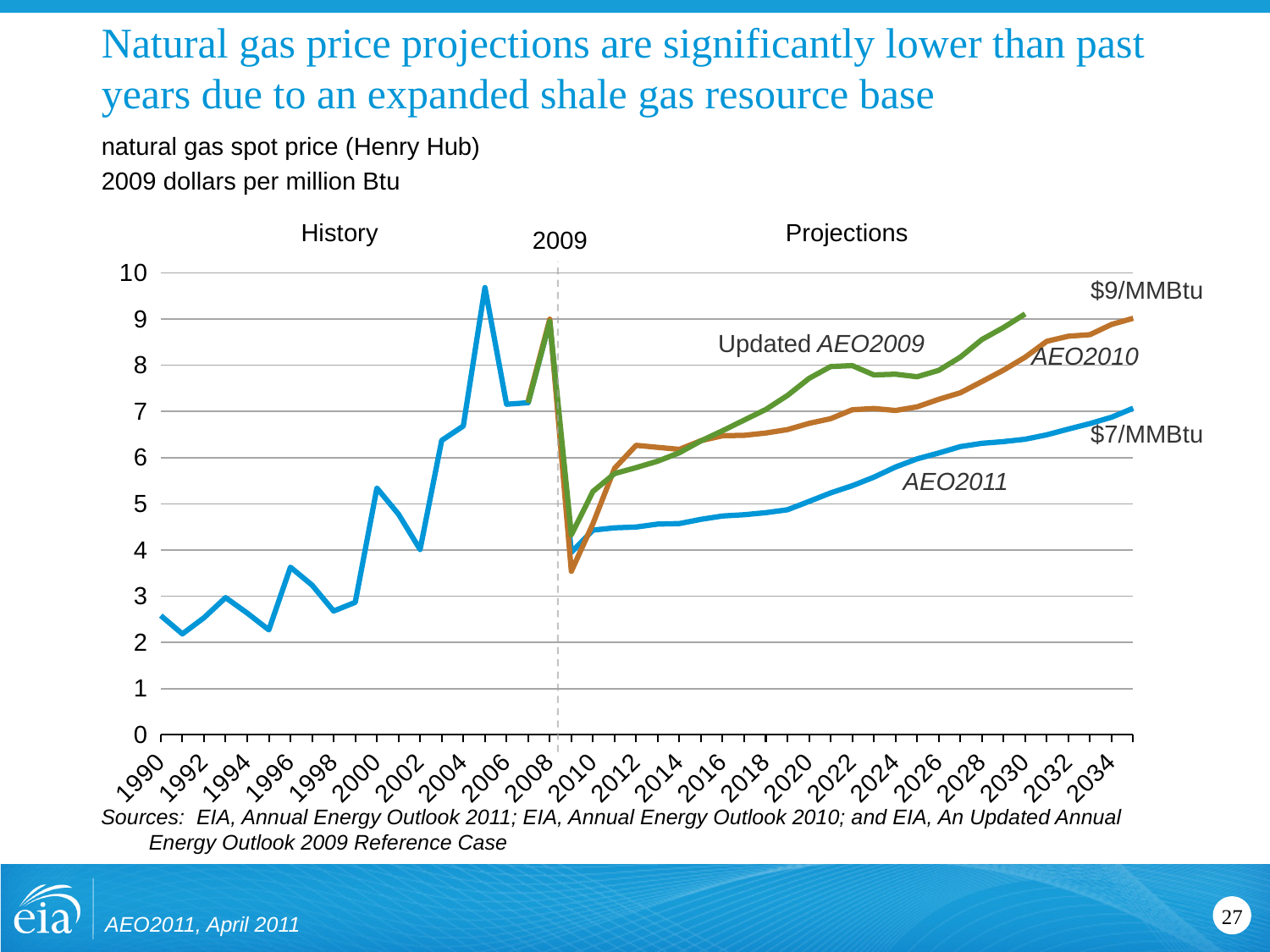
How many projection series are labeled on the chart? 3 Which projection series is lowest in 2030? AEO2011 In 2020, which is larger: the AEO2010 value or the AEO2011 value? AEO2010 What kind of chart is shown on the slide? line chart Which year does the dashed vertical line separating History from Projections mark? 2009 Does the AEO2011 projection rise or fall from 2010 to 2034? rise Is the Updated AEO2009 value for 2020 greater or less than 7? greater What units are the prices on the chart expressed in? 2009 dollars per million Btu Is the historical value for 1990 greater or less than 3? less Is the AEO2011 value for 2030 greater or less than 6? greater Which projection series is highest in 2030? Updated AEO2009